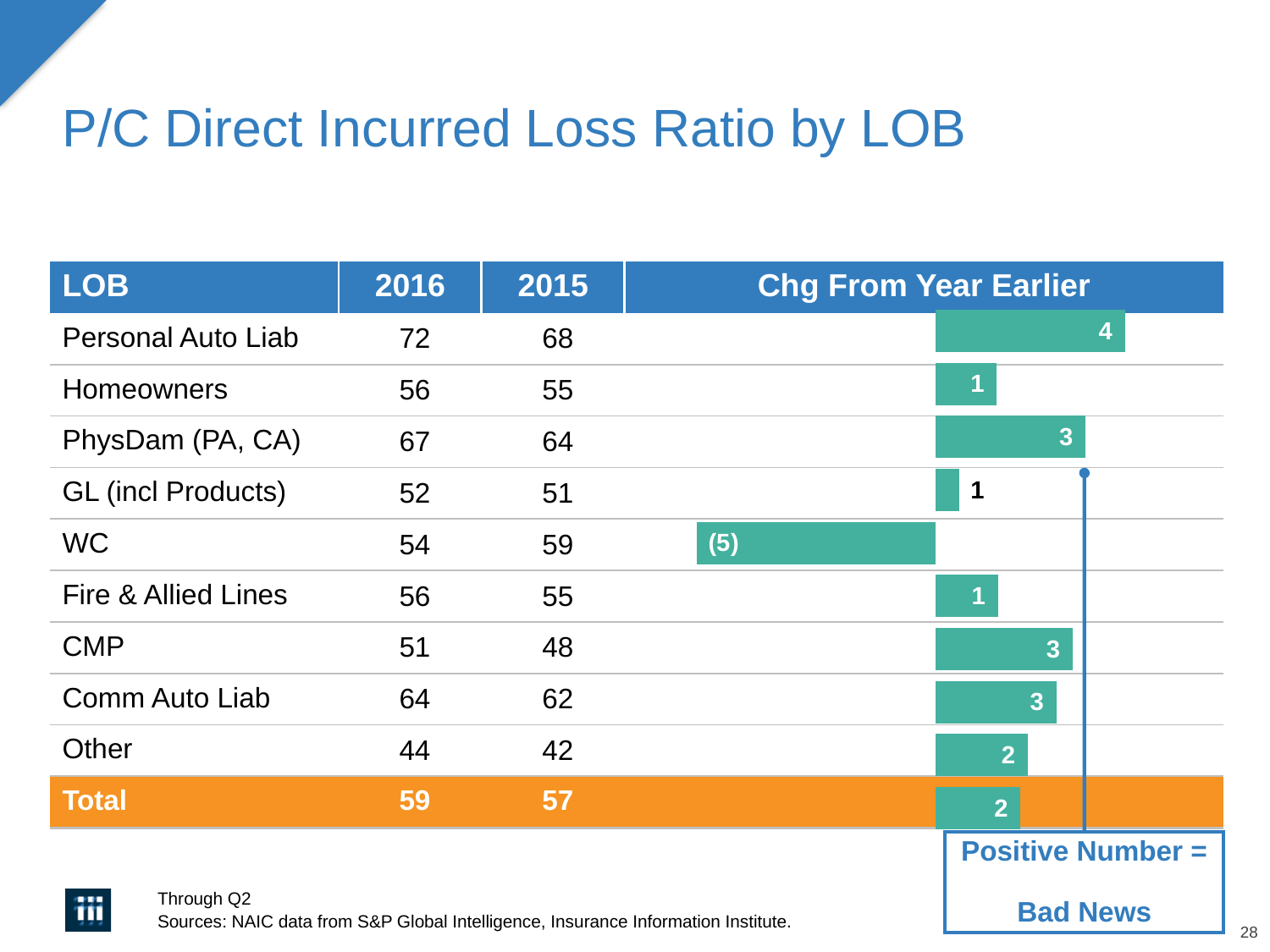
What is the change from a year earlier shown for Personal Auto Liab? 4 What is the change from a year earlier shown for Other? 2 What is the difference between the change for Personal Auto Liab and the change for Other? 2 How many bars are shown in the Chg From Year Earlier column, including the Total row? 10 What is the heading of the column containing the bars? Chg From Year Earlier Which has a larger change from a year earlier, Personal Auto Liab or CMP? Personal Auto Liab What kind of chart is used in the Chg From Year Earlier column? Bar chart What is the change from a year earlier shown for the Total row? 2 According to the note on the slide, what does a positive number indicate? Bad News Which line of business has the lowest change from a year earlier? WC Which line of business has the largest positive change from a year earlier? Personal Auto Liab What is the change from a year earlier shown for WC? (5)